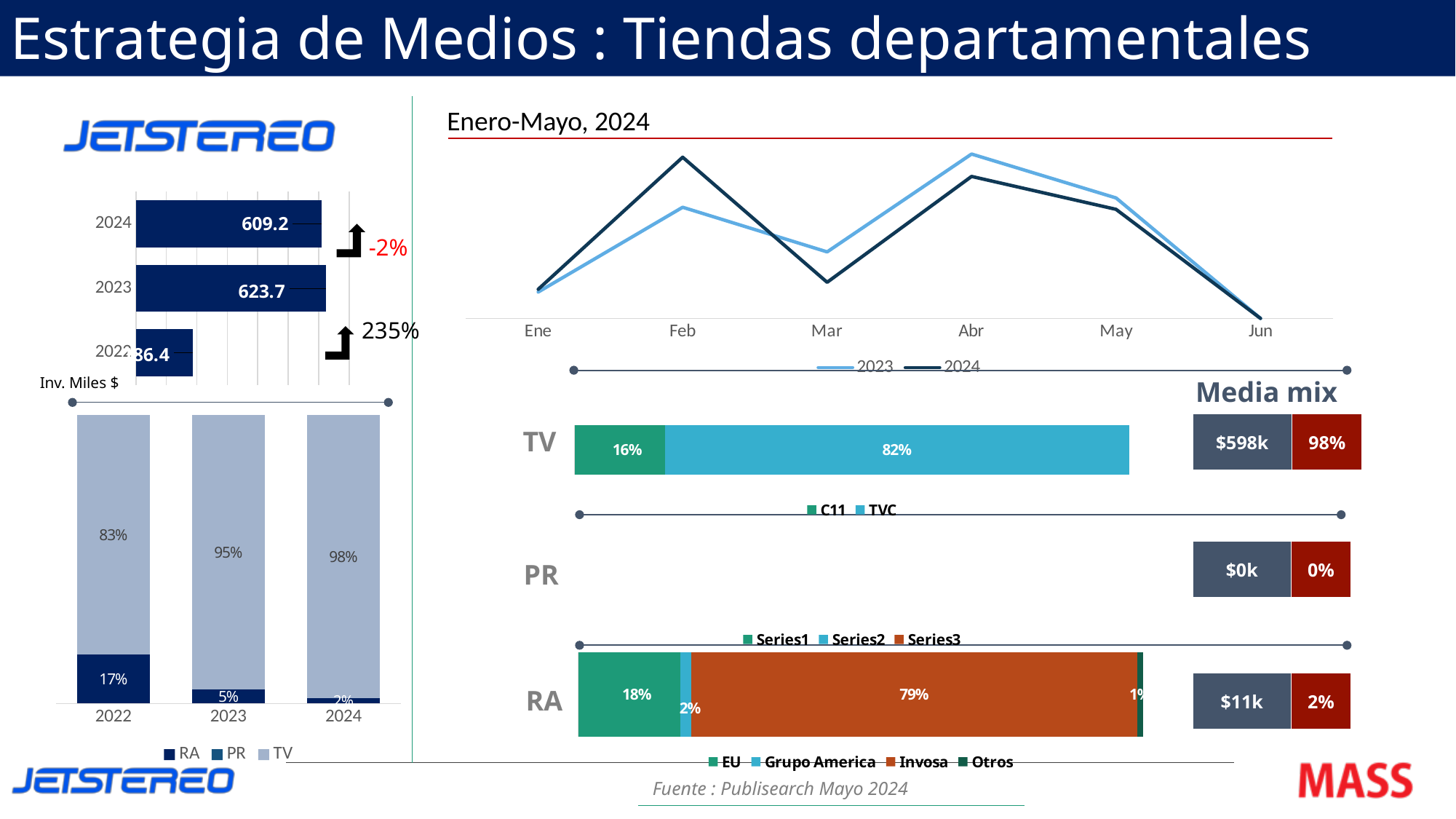
In the horizontal bar chart at the top left (Inv. Miles $), what is the value for 2023? 623.7 In the line chart titled Enero-Mayo, 2024, how many months are shown on the x axis? 6 In the Media mix boxes, what is the dollar amount shown for RA? $11k In the stacked bar chart at the bottom left, how many series does the legend list? 3 In the horizontal bar chart at the top left (Inv. Miles $), what is the difference between the 2023 and 2024 values? 14.5 In the stacked bar chart at the bottom left, what share does RA have in 2022? 17% In the TV stacked bar chart, what is the share for TVC? 82% In the RA stacked bar chart, which category has the largest share? Invosa In the horizontal bar chart at the top left (Inv. Miles $), which year has the highest value? 2023 In the line chart titled Enero-Mayo, 2024, which series is higher in Feb, 2023 or 2024? 2024 In the horizontal bar chart at the top left (Inv. Miles $), what is the value for 2024? 609.2 In the stacked bar chart at the bottom left, what share does TV have in 2023? 95%